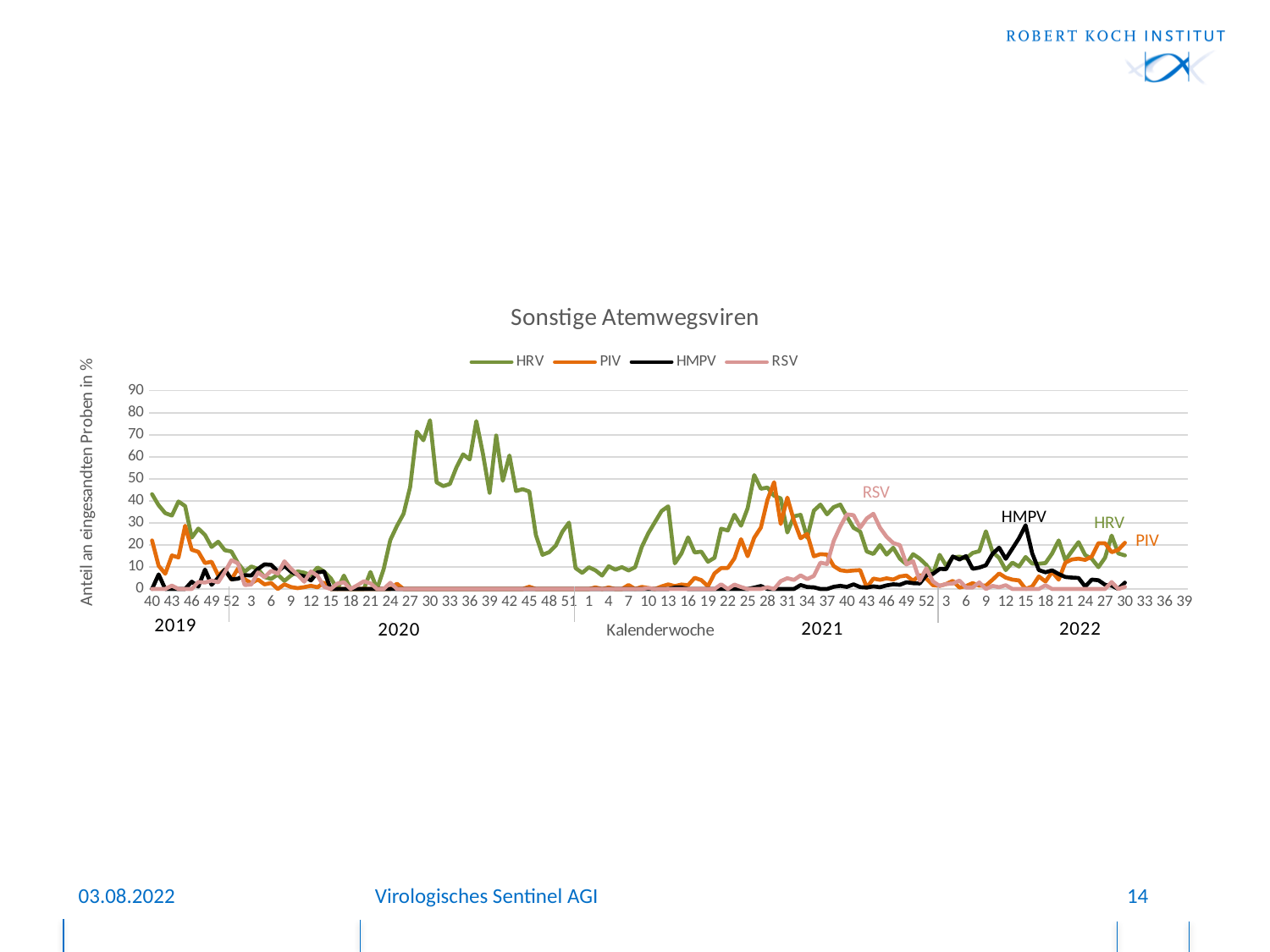
Is the highest peak of the PIV line in 2021 greater or less than 40? greater What is the title of the chart? Sonstige Atemwegsviren Is the value of the HMPV line at week 40 of 2019 greater or less than 10? less Which series reaches the highest value anywhere in the chart? HRV Does the HRV line rise or fall between week 40 and week 52 of 2019? fall Is the highest peak of the HMPV line in 2022 greater or less than 20? greater What is the label of the vertical axis of the chart? Anteil an eingesandten Proben in % Which series has the higher peak in 2021, PIV or RSV? PIV What kind of chart is shown on the slide? line chart How many series does the legend of the chart list? 4